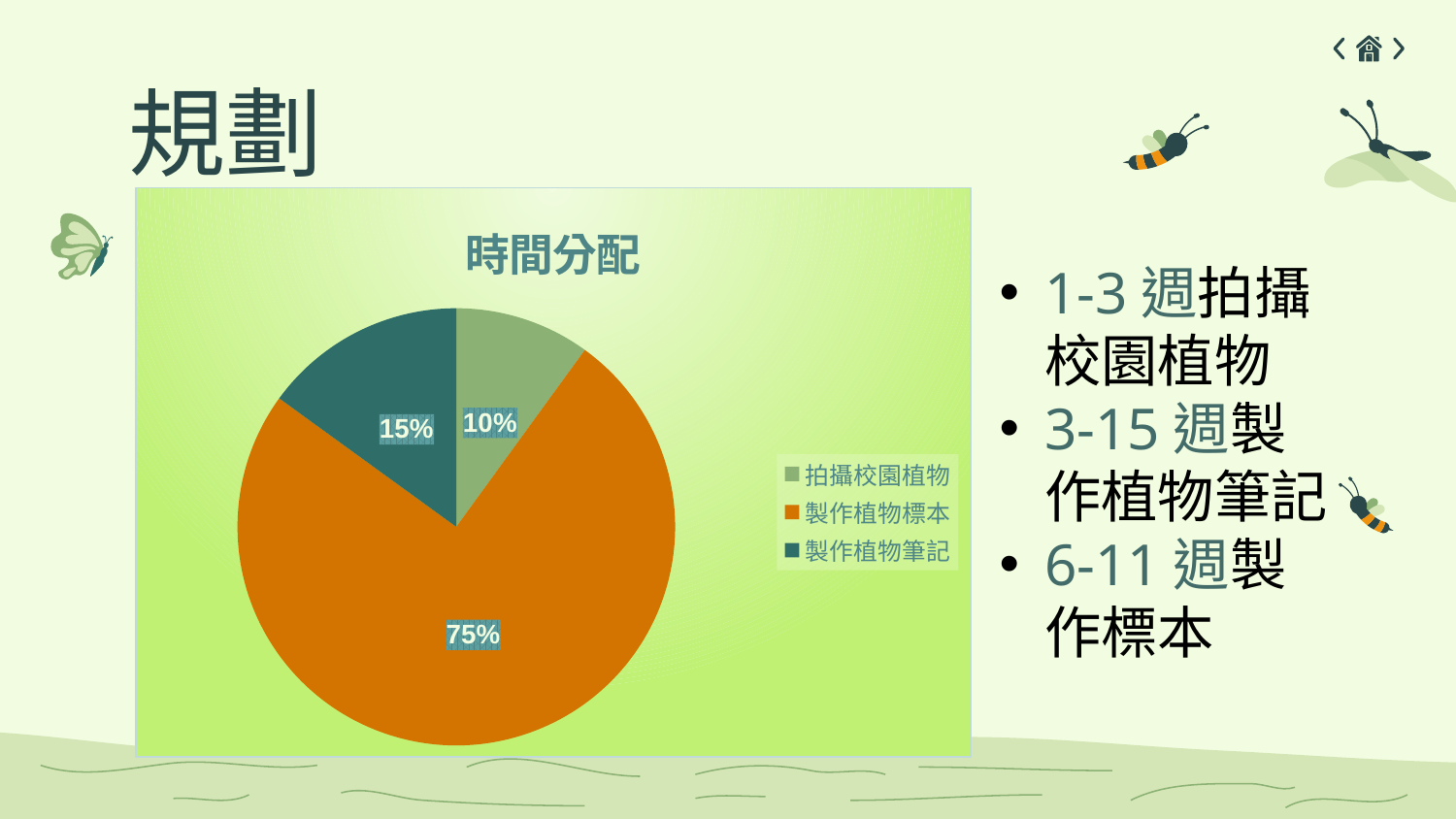
What percentage of the pie is 製作植物標本? 75% What is the difference between the shares of 製作植物筆記 and 拍攝校園植物? 5% What is the difference between the shares of 製作植物標本 and 製作植物筆記? 60% Which category has the smallest share of the pie? 拍攝校園植物 What type of chart is shown on the slide? pie chart Which is larger, the share for 製作植物筆記 or the share for 拍攝校園植物? 製作植物筆記 Which category has the largest share of the pie? 製作植物標本 How many categories does the pie chart have? 3 What percentage of the pie is 製作植物筆記? 15% What percentage of the pie is 拍攝校園植物? 10% What is the title of the chart? 時間分配 Which colour represents 製作植物標本 in the legend? orange